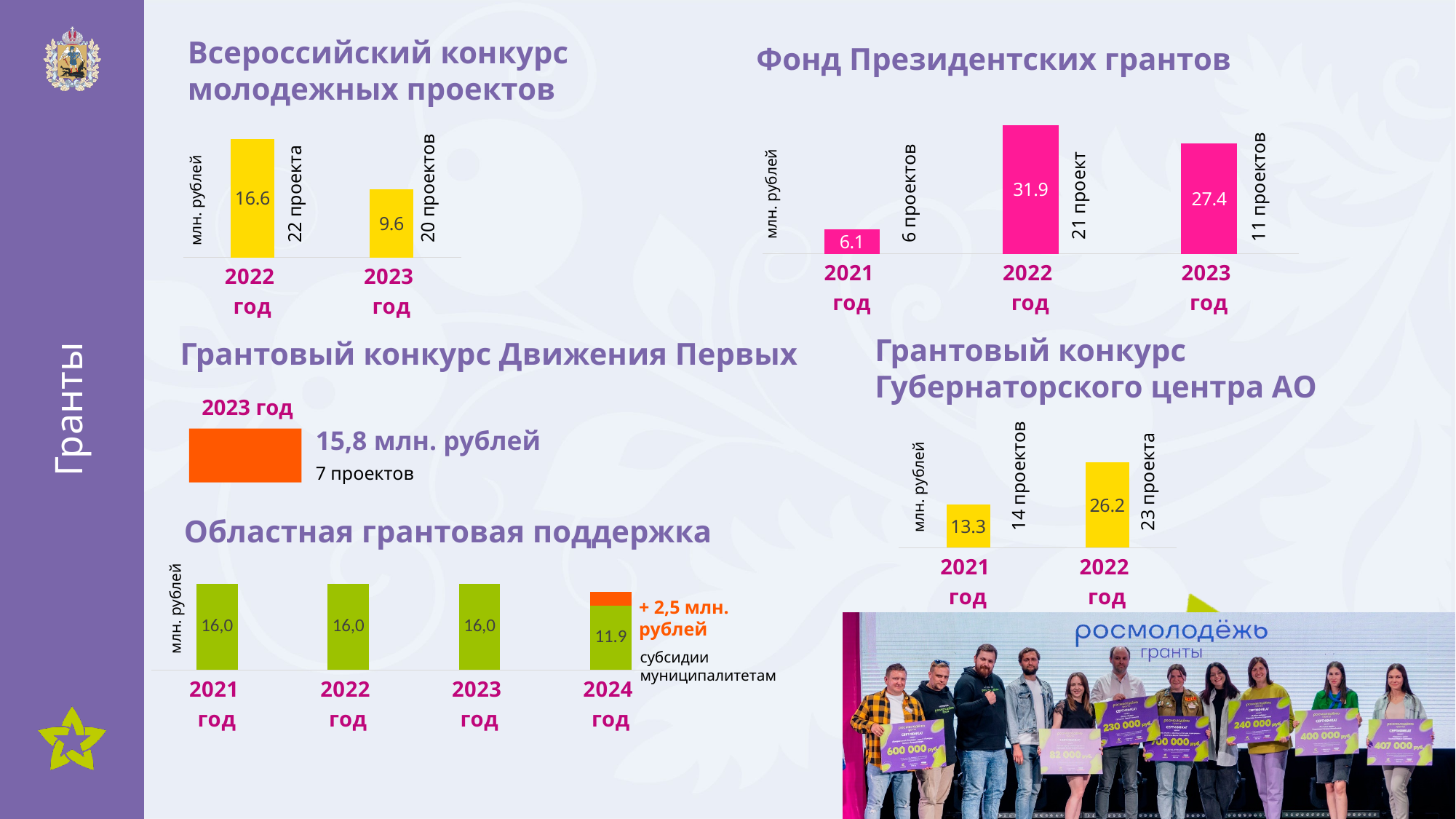
What type of chart is used for 'Областная грантовая поддержка'? bar chart In the 'Фонд Президентских грантов' chart, what is the difference between the values for 2022 год and 2023 год? 4.5 In the 'Фонд Президентских грантов' chart, what is the value for 2022 год? 31.9 In the 'Всероссийский конкурс молодежных проектов' chart, do the values rise or fall from 2022 to 2023? fall In the 'Грантовый конкурс Губернаторского центра АО' chart, what is the value for 2021 год? 13.3 In the 'Фонд Президентских грантов' chart, which year has the lowest value? 2021 год In the 'Областная грантовая поддержка' chart, what is the green bar value for 2024 год? 11.9 In the 'Грантовый конкурс Губернаторского центра АО' chart, which year has the higher value, 2021 or 2022? 2022 год In the 'Всероссийский конкурс молодежных проектов' chart, what is the value for 2023 год? 9.6 In the 'Всероссийский конкурс молодежных проектов' chart, how many projects are noted for 2022 год? 22 проекта In the 'Областная грантовая поддержка' chart, what is the value for 2022 год? 16,0 How many bars are in the 'Фонд Президентских грантов' chart? 3